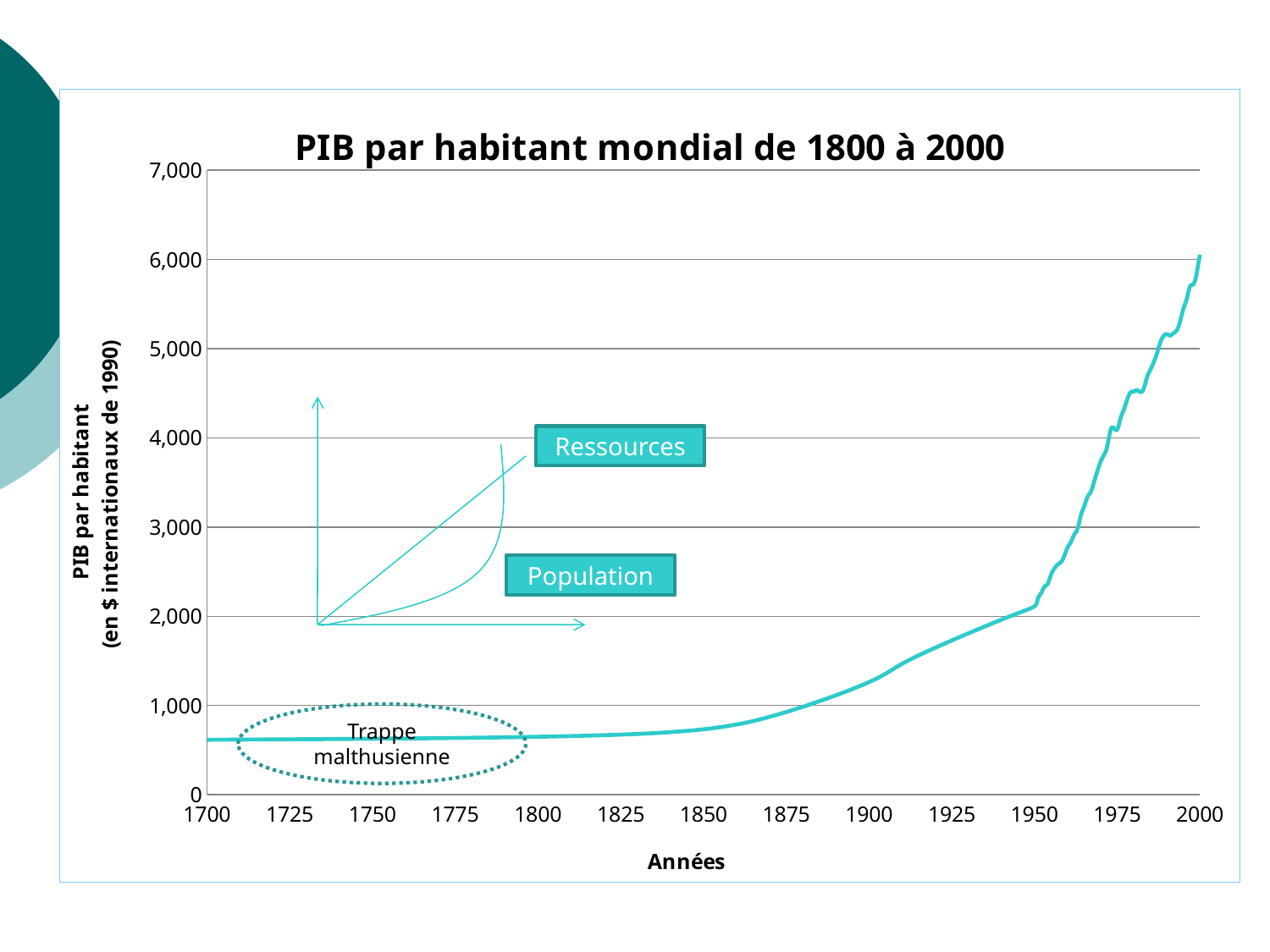
Which is larger, the value for 1950 or the value for 1900? 1950 Which year shown on the x axis has the highest PIB par habitant? 2000 Is the value for 1900 greater or less than 1,000? greater Is the value for 1850 greater or less than 1,000? less What kind of chart is shown on the slide? line chart Is the value for 1800 greater or less than 1,000? less What is the title of the chart? PIB par habitant mondial de 1800 à 2000 Does the PIB par habitant rise or fall from 1700 to 2000? rise What is the label of the x axis? Années What is the first year shown on the x axis? 1700